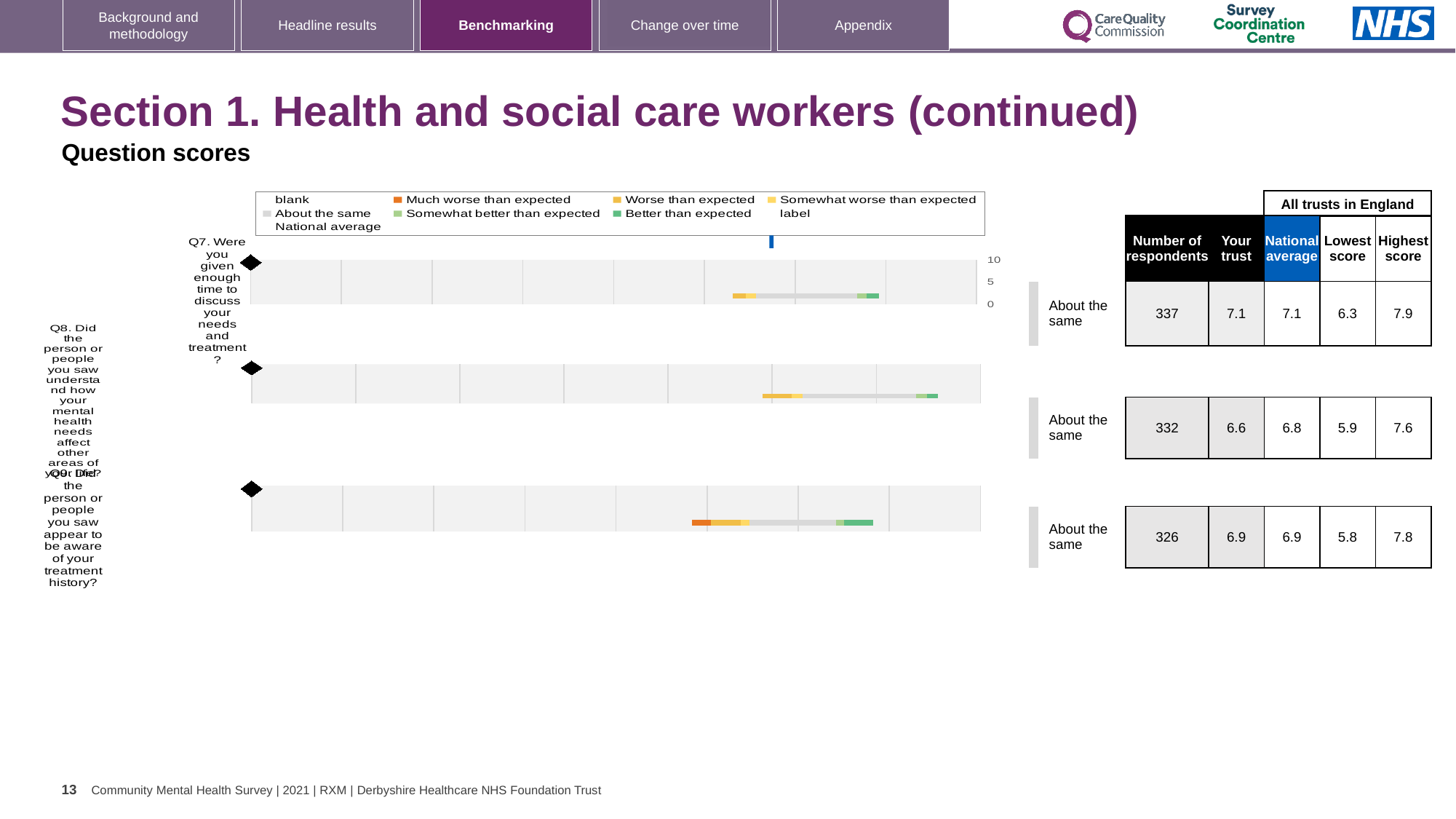
Is the 'Your trust' score for Q8 larger or smaller than the national average for Q8? smaller What colour is the 'Much worse than expected' legend entry? orange Which of the three questions has the lowest 'Your trust' score? Q8 What is the difference between the highest score and the lowest score for Q8? 1.7 What is the national average score for Q8 (Did the person or people you saw understand how your mental health needs affect other areas of your life?)? 6.8 What is the 'Your trust' score for Q7 (Were you given enough time to discuss your needs and treatment?)? 7.1 What benchmark category is shown for Q7, Q8 and Q9? About the same What kind of chart is used to show the question scores on this slide? bar chart How many questions (Q7, Q8, Q9) are plotted on this slide? 3 Which of the three questions has the highest number of respondents? Q7 How many respondents answered Q9 (Did the person or people you saw appear to be aware of your treatment history?)? 326 What is the highest score across all trusts in England for Q9? 7.8